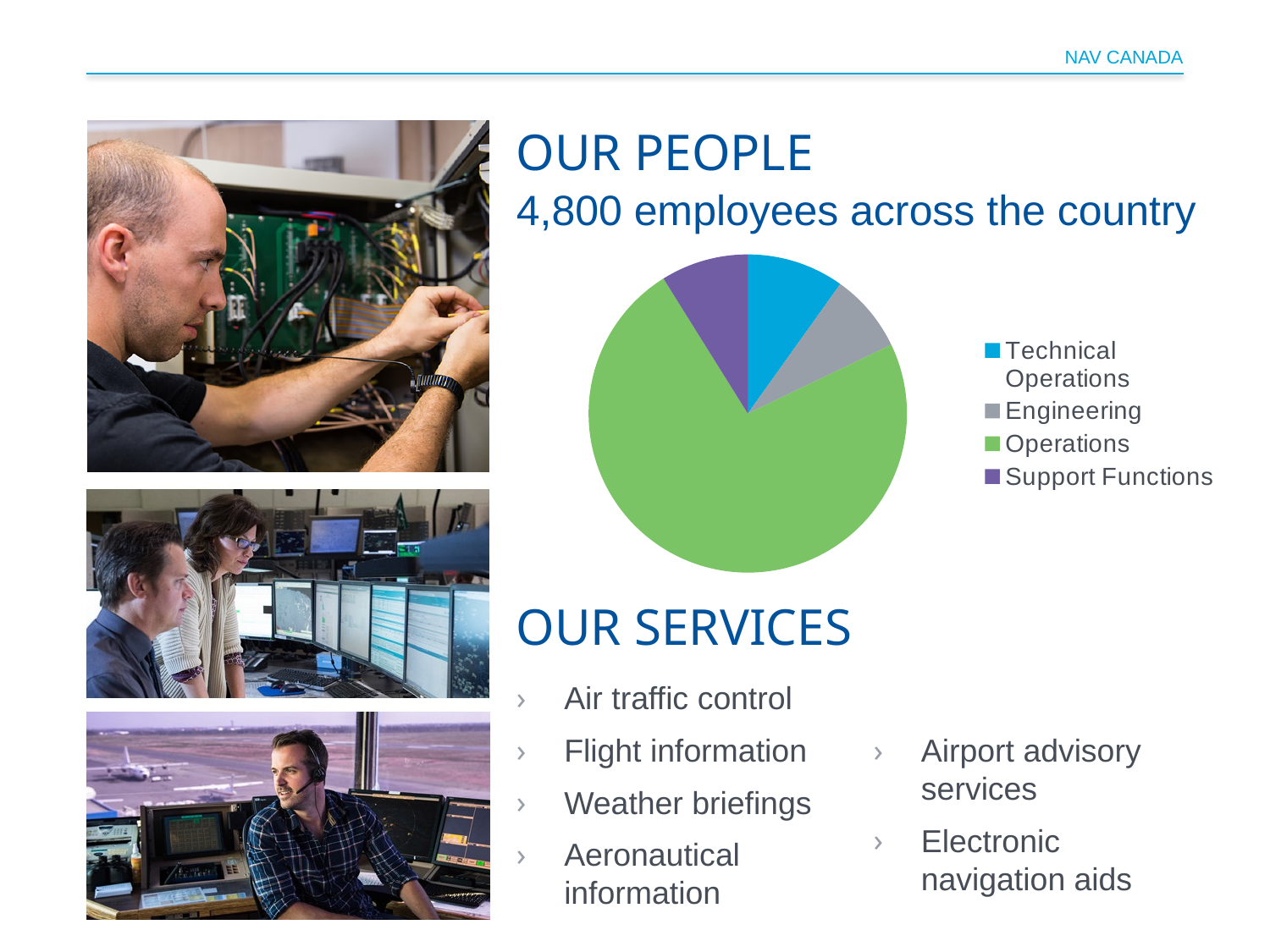
What total number of employees does the heading above the pie chart state? 4,800 Which category has the largest slice of the pie chart? Operations What kind of chart is shown on the slide? pie chart Which slice is larger in the pie chart, Operations or Technical Operations? Operations Does the Operations slice account for more or less than half of the pie chart? more How many categories does the pie chart's legend list? 4 Which slice is larger in the pie chart, Operations or Support Functions? Operations Which slice is larger in the pie chart, Operations or Engineering? Operations Which category is shown in green in the pie chart? Operations